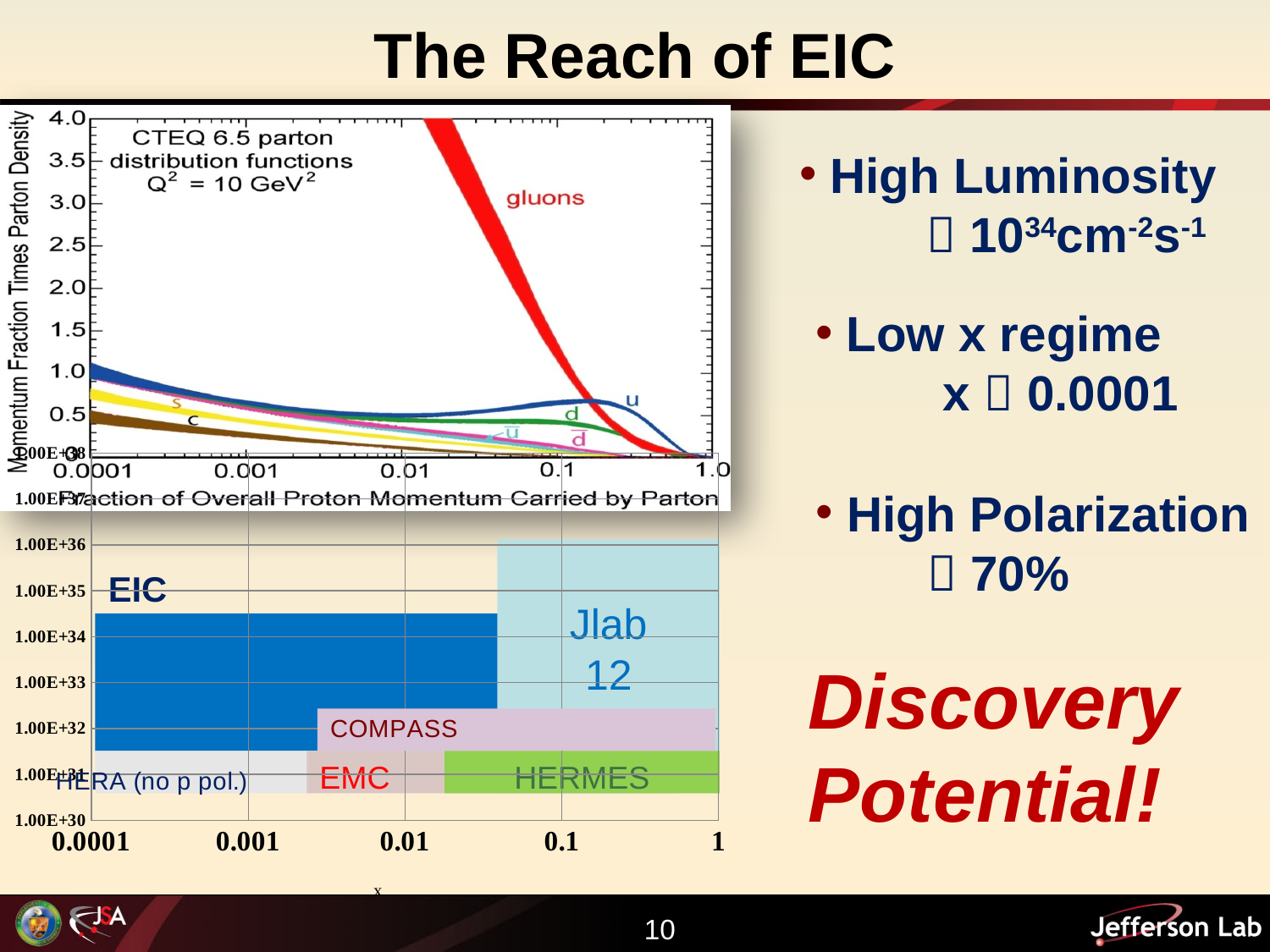
In the bottom chart, is the top of the EIC region greater or less than 1.00E+34? greater In the top chart, how many labelled parton curves are shown? 7 In the top chart, what kind of chart is it? line chart In the top chart, does the gluon curve rise or fall as x increases from 0.01 to 1.0? fall In the bottom chart, which region reaches higher luminosity, EIC or COMPASS? EIC In the top chart, what is the maximum value shown on the y axis? 4.0 In the bottom chart, how many labelled experiment regions are shown? 6 In the top chart, what is the label of the x axis? Fraction of Overall Proton Momentum Carried by Parton In the bottom chart, which experiment region reaches the highest luminosity? Jlab 12 In the top chart, which parton curve is labelled in red and rises highest at low x? gluons In the bottom chart, is the top of the HERMES region greater or less than 1.00E+32? less In the top chart, what value of Q² is stated in the chart's annotation? 10 GeV²